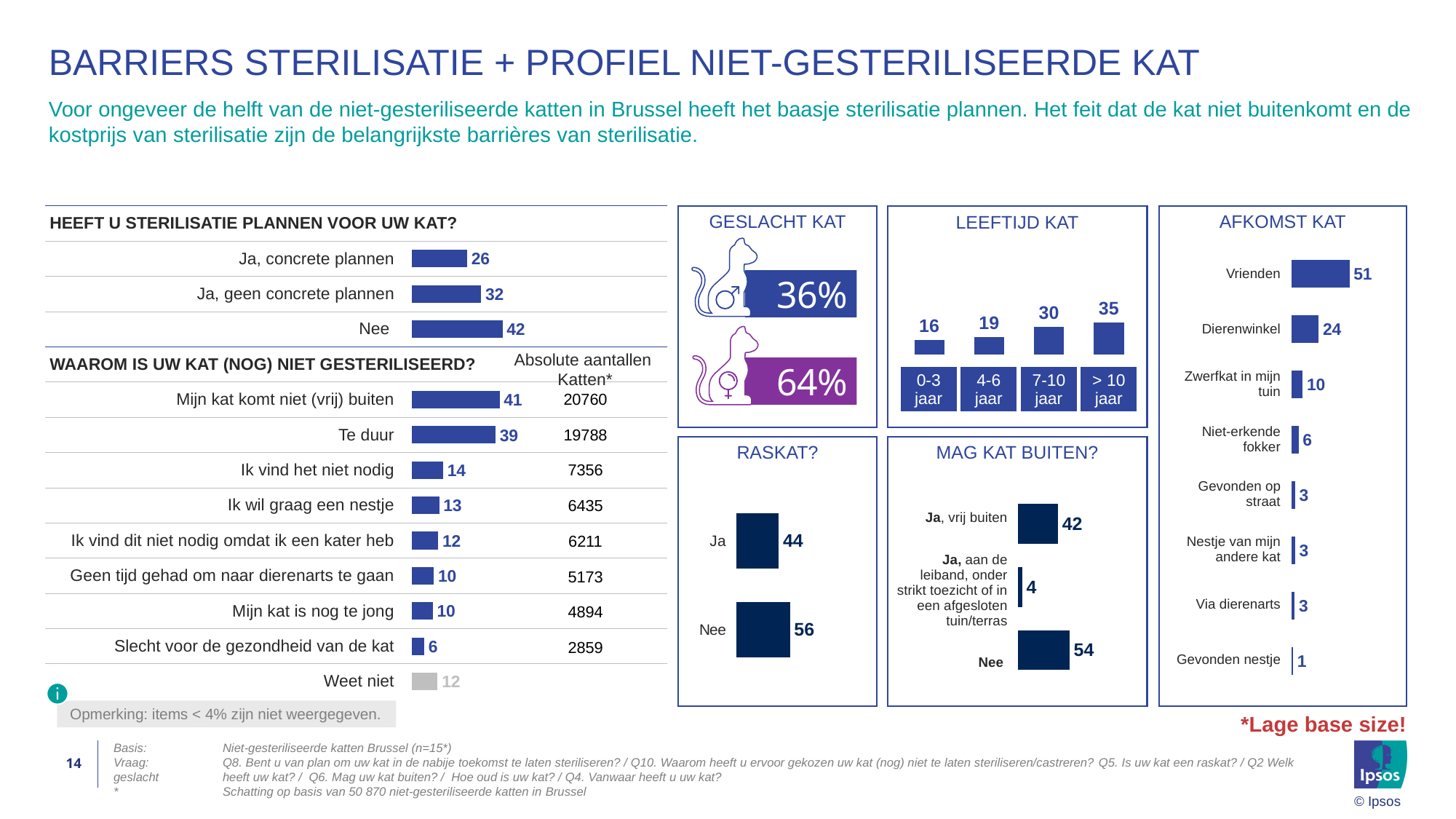
In the 'LEEFTIJD KAT' chart, which age group has the highest value? > 10 jaar In the 'LEEFTIJD KAT' chart, how many age groups are shown? 4 In the 'RASKAT?' chart, which is larger, 'Ja' or 'Nee'? Nee In the 'MAG KAT BUITEN?' chart, what is the value for 'Nee'? 54 In the 'HEEFT U STERILISATIE PLANNEN VOOR UW KAT?' chart, which category has the lowest value? Ja, concrete plannen In the 'HEEFT U STERILISATIE PLANNEN VOOR UW KAT?' chart, what is the value for 'Nee'? 42 In the 'LEEFTIJD KAT' chart, do the values rise or fall from '0-3 jaar' to '> 10 jaar'? rise In the 'WAAROM IS UW KAT (NOG) NIET GESTERILISEERD?' chart, what is the value for 'Te duur'? 39 In the 'WAAROM IS UW KAT (NOG) NIET GESTERILISEERD?' chart, what is the difference between 'Mijn kat komt niet (vrij) buiten' and 'Ik vind het niet nodig'? 27 In the 'AFKOMST KAT' chart, what is the difference between 'Vrienden' and 'Dierenwinkel'? 27 In the 'WAAROM IS UW KAT (NOG) NIET GESTERILISEERD?' chart, what is the absolute number of cats for 'Ik wil graag een nestje'? 6435 In the 'GESLACHT KAT' chart, what is the share of female cats? 64%